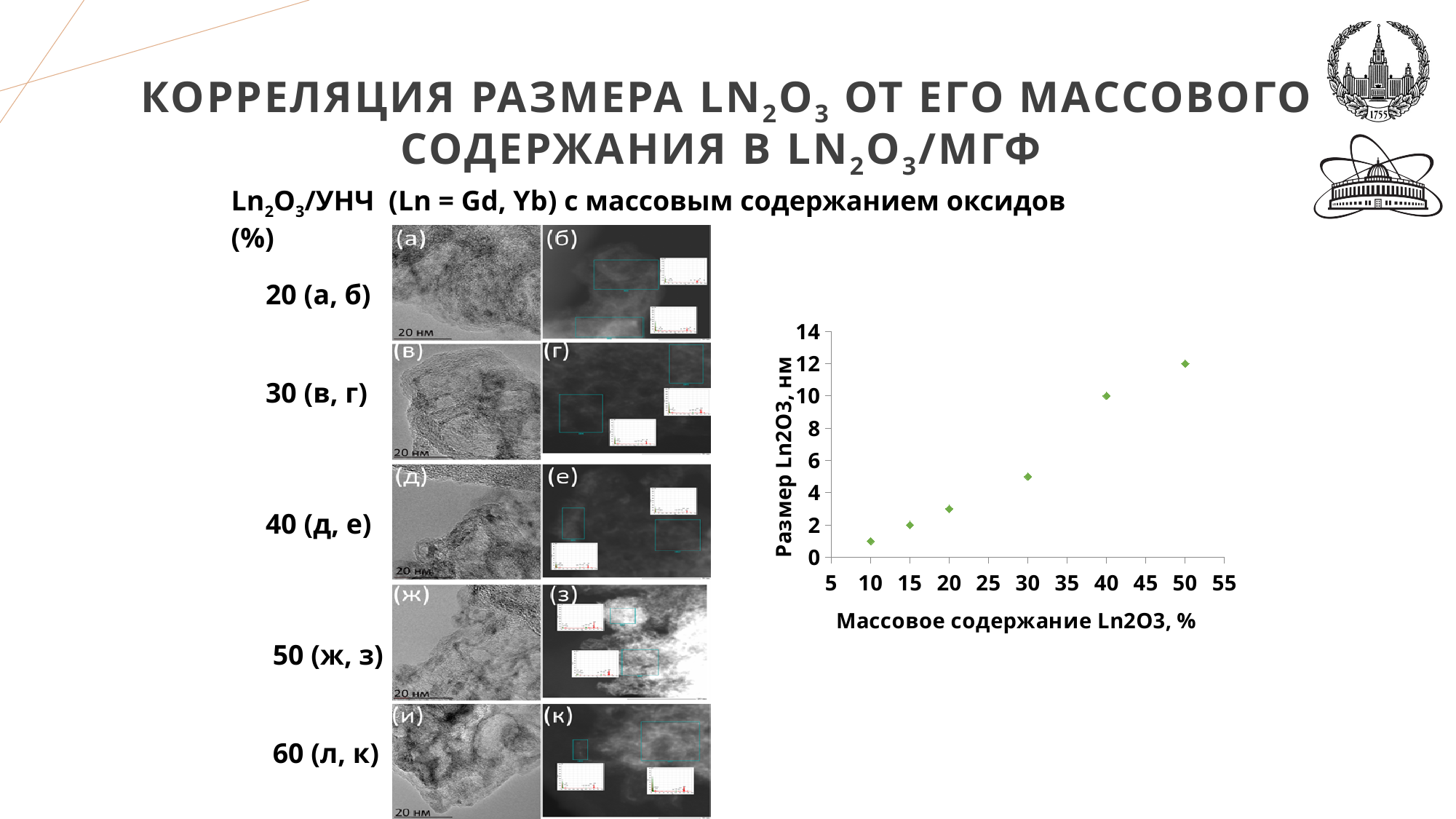
At which mass content is the Ln2O3 size the highest? 50 How many data points are plotted on the chart? 6 At which mass content is the Ln2O3 size the lowest? 10 Which has a larger Ln2O3 size: the point at 40% or the point at 20% mass content? 40% What is the Ln2O3 size (nm) at a mass content of 15%? 2 Is the Ln2O3 size at 30% mass content greater or less than 4? greater What is the Ln2O3 size (nm) at a mass content of 40%? 10 What kind of chart is shown on the slide? scatter chart What is the Ln2O3 size (nm) at a mass content of 50%? 12 What is the difference in Ln2O3 size between the points at 50% and 40% mass content? 2 Do the Ln2O3 size values rise or fall as the mass content increases along the x axis? rise What is the title of the y axis of the chart? Размер Ln2O3, нм